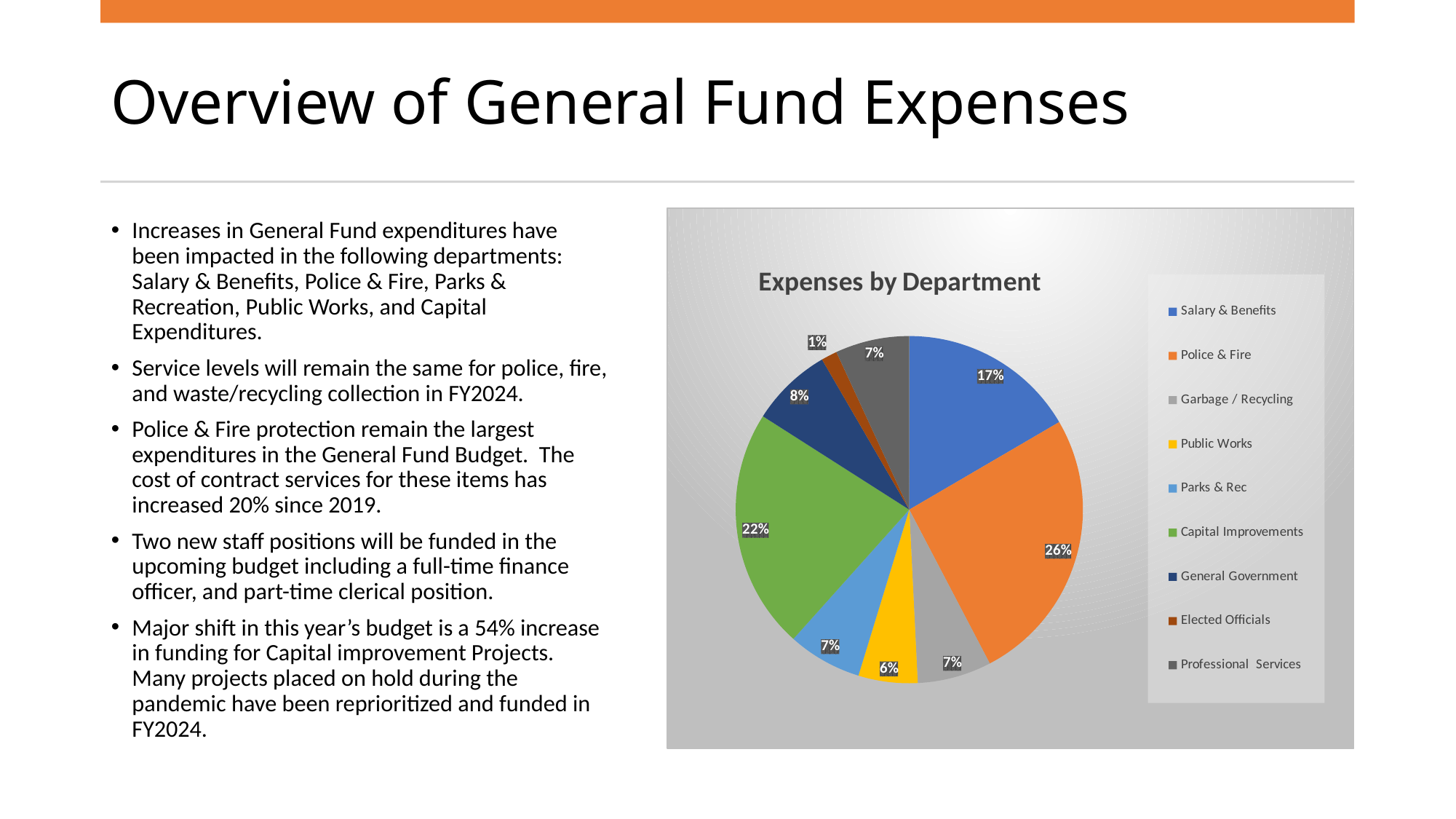
Which is larger, the share for Capital Improvements or the share for Salary & Benefits? Capital Improvements What is the value shown for General Government? 8% Which department has the largest share of expenses? Police & Fire What is the difference in percentage points between Police & Fire and Salary & Benefits? 9 What is the value shown for Public Works? 6% What share of expenses does Capital Improvements account for? 22% Which department has the smallest share of expenses? Elected Officials What type of chart is shown on the slide? Pie chart What is the title of the chart? Expenses by Department What share of expenses does Police & Fire account for? 26% What is the value shown for Salary & Benefits? 17% How many categories does the legend of the pie chart list? 9